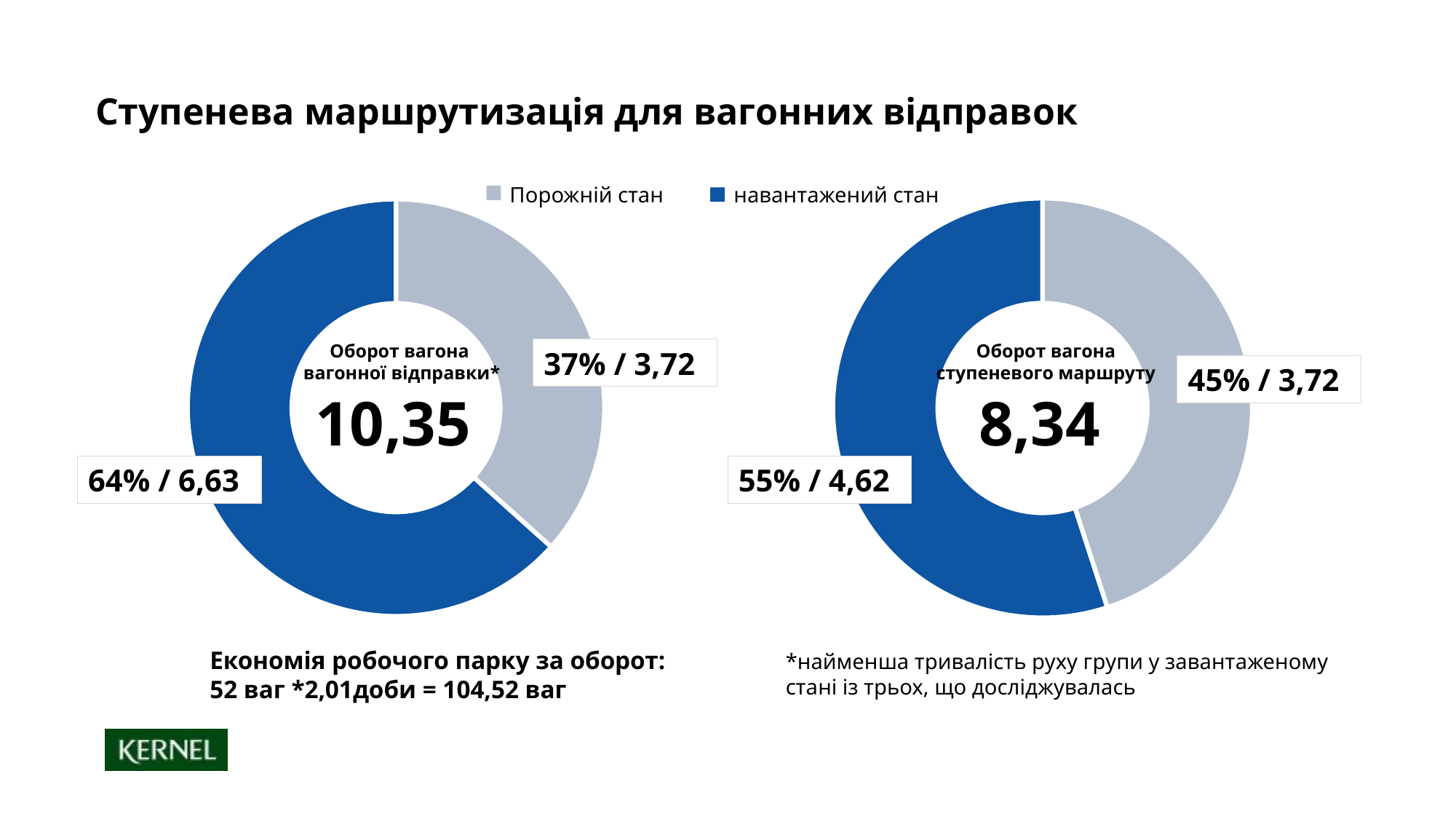
What value is shown in the centre of the left chart (Оборот вагона вагонної відправки*)? 10,35 In the left chart (Оборот вагона вагонної відправки*), what is the difference between the навантажений стан value (6,63) and the Порожній стан value (3,72)? 2,91 In the right chart (Оборот вагона ступеневого маршруту), what is the label shown for the навантажений стан slice? 55% / 4,62 What value is shown in the centre of the right chart (Оборот вагона ступеневого маршруту)? 8,34 In the left chart (Оборот вагона вагонної відправки*), what is the label shown for the Порожній стан slice? 37% / 3,72 In the left chart (Оборот вагона вагонної відправки*), what is the label shown for the навантажений стан slice? 64% / 6,63 How many series does the legend list? 2 Which colour represents Порожній стан in the legend? Light grey What type of chart is used on this slide? Donut (pie) chart In the right chart (Оборот вагона ступеневого маршруту), what is the label shown for the Порожній стан slice? 45% / 3,72 In the right chart (Оборот вагона ступеневого маршруту), what share of the donut does the Порожній стан slice represent? 45% In the left chart (Оборот вагона вагонної відправки*), which slice is larger: Порожній стан or навантажений стан? навантажений стан